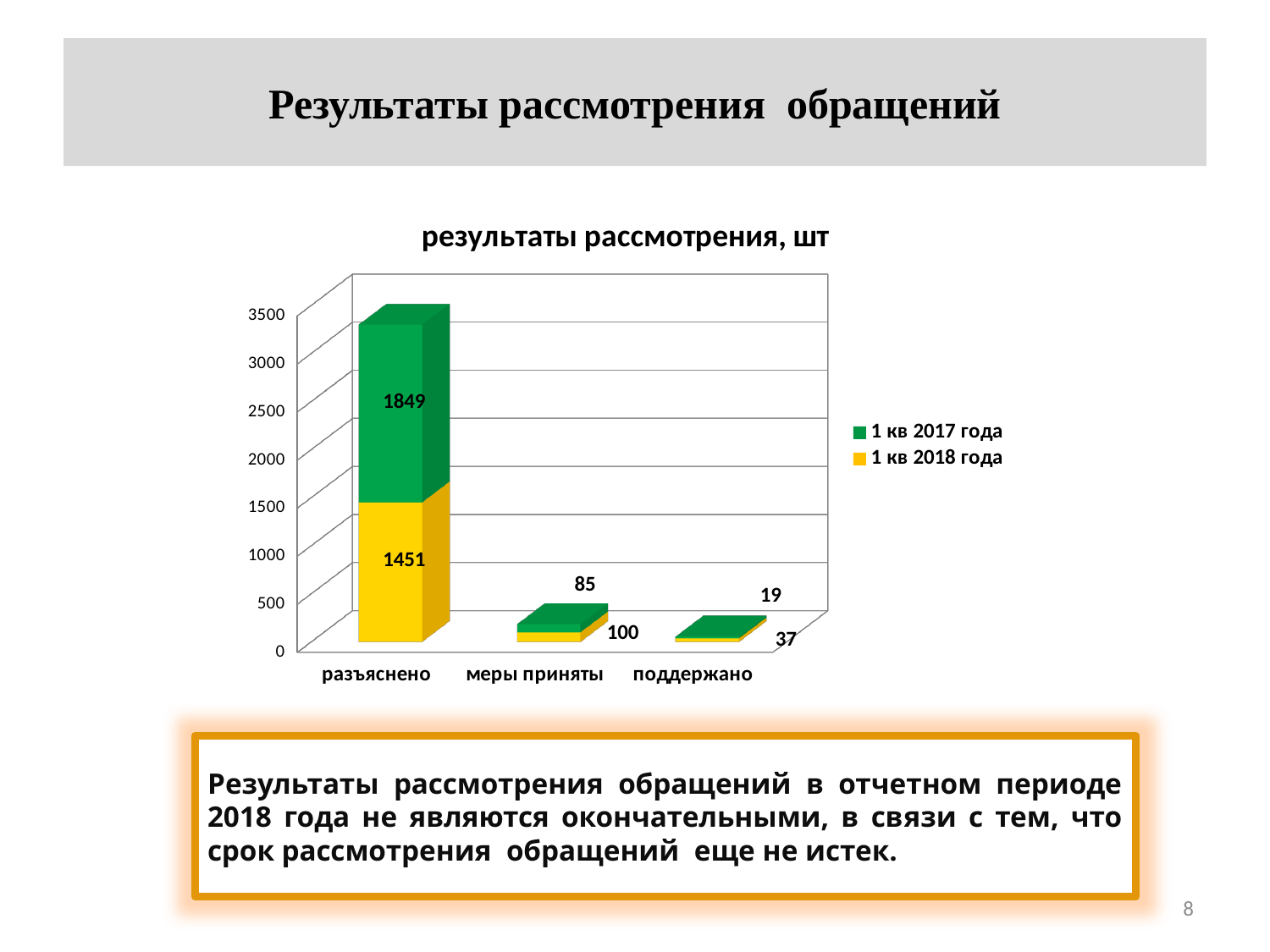
What is the difference between the 1 кв 2017 года and 1 кв 2018 года values for разъяснено? 398 Which category has the lowest value for 1 кв 2018 года? поддержано What is the value for 1 кв 2018 года in the меры приняты category? 100 How many categories are shown on the x axis? 3 What is the value for 1 кв 2017 года in the поддержано category? 19 What is the value for 1 кв 2017 года in the разъяснено category? 1849 Which is larger for меры приняты: the value for 1 кв 2017 года or for 1 кв 2018 года? 1 кв 2018 года How many series does the legend list? 2 What is the value for 1 кв 2018 года in the разъяснено category? 1451 What is the total of the stacked bar for поддержано? 56 What kind of chart is shown on the slide? Stacked bar chart Which category has the highest value for 1 кв 2017 года? разъяснено